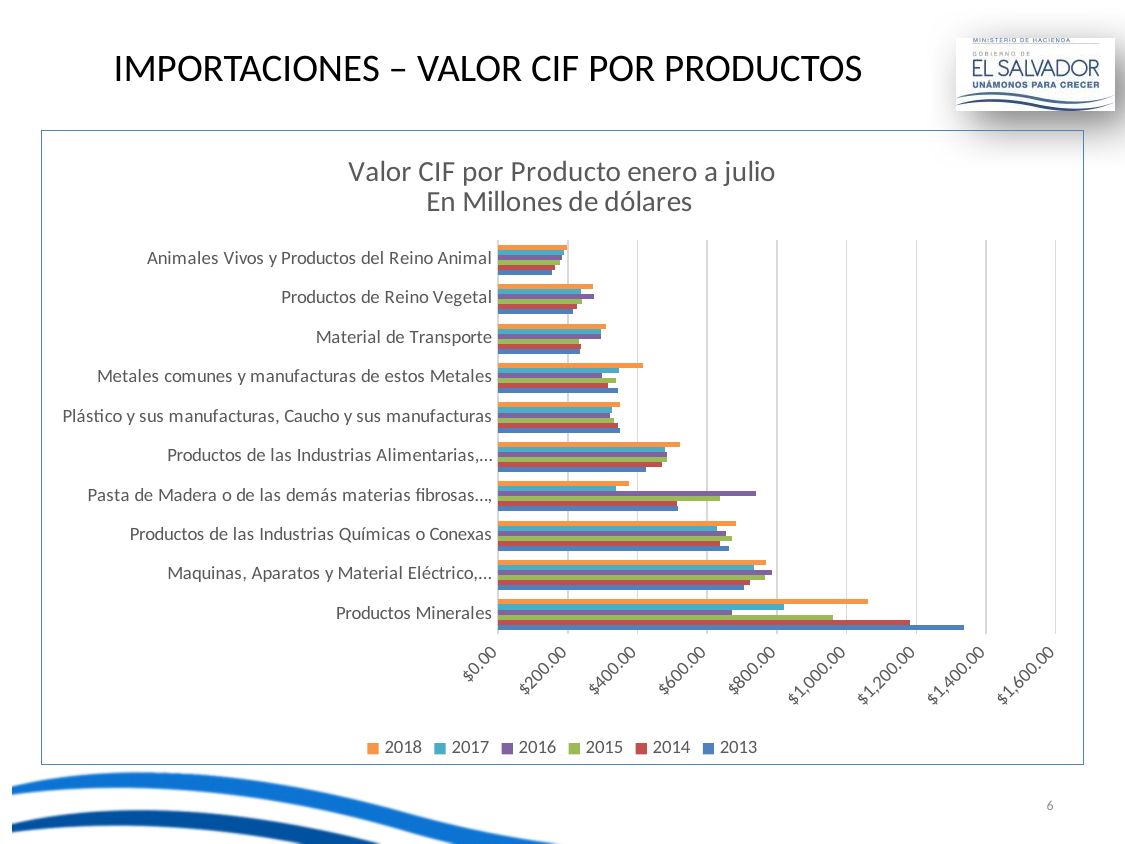
How many series does the legend list? 6 Is the 2016 value for Pasta de Madera o de las demás materias fibrosas greater or less than $600.00? greater What kind of chart is shown on the slide? bar chart Is the 2018 value for Material de Transporte greater or less than $400.00? less Is the 2013 value for Animales Vivos y Productos del Reino Animal greater or less than $200.00? less Which product category has the longest bars overall? Productos Minerales For Productos Minerales, which year has the highest value? 2013 For Pasta de Madera o de las demás materias fibrosas, which is larger: the 2016 value or the 2018 value? 2016 Which product category has the shortest bars overall? Animales Vivos y Productos del Reino Animal What is the title of the chart? Valor CIF por Producto enero a julio En Millones de dólares How many product categories are plotted on the chart? 10